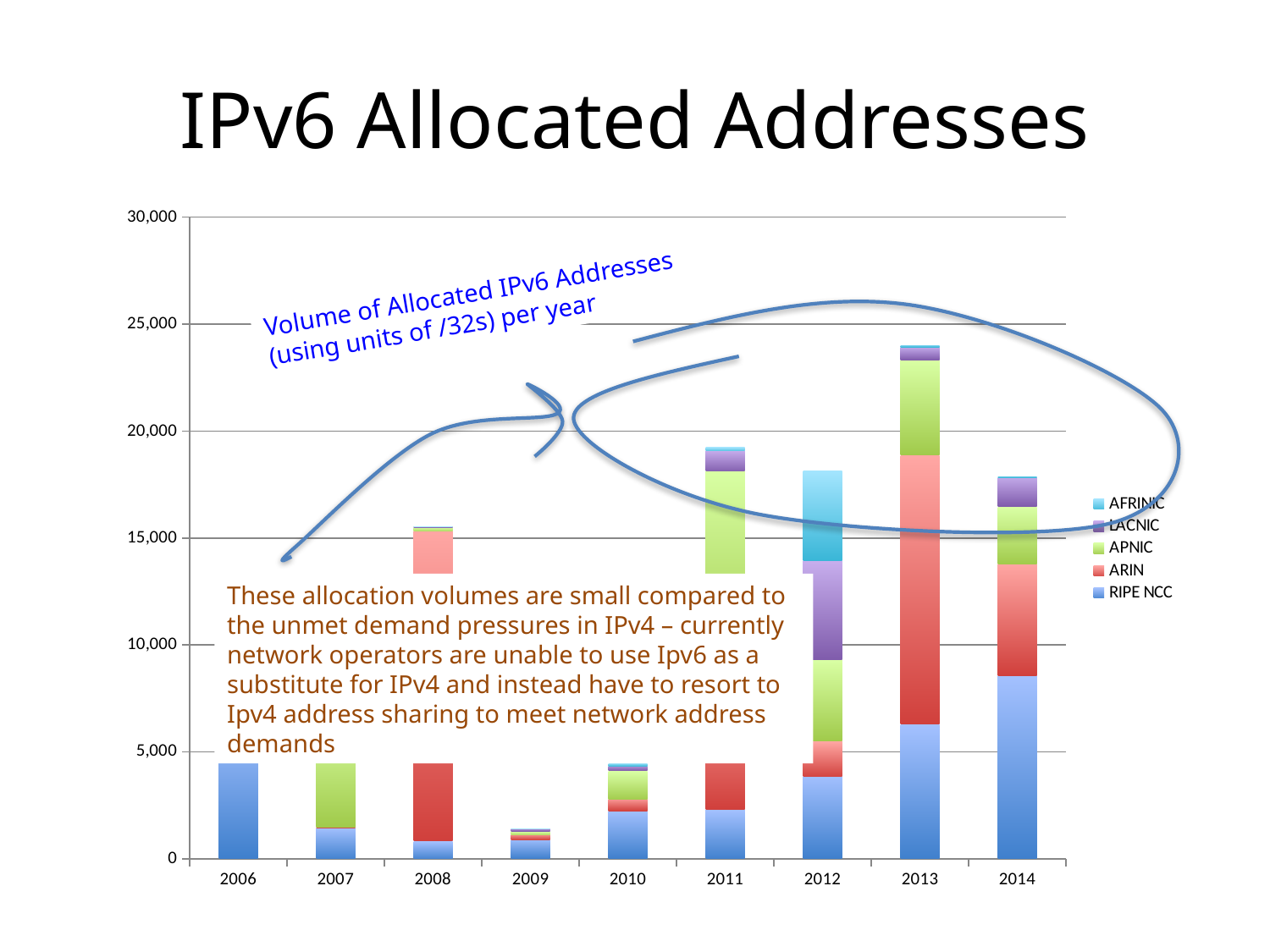
Which year has the taller stacked bar, 2013 or 2014? 2013 How many years are shown along the x axis of the chart? 9 Which year has the taller stacked bar, 2006 or 2009? 2006 Which year has the tallest stacked bar in the chart? 2013 Which year has the shortest stacked bar in the chart? 2009 Is the total stacked value for 2009 greater or less than 5,000? less What kind of chart is shown on the slide? Stacked bar chart Is the total stacked value for 2014 greater or less than 20,000? less Is the total stacked value for 2011 greater or less than 15,000? greater How many series does the chart's legend list? 5 Which series is listed first in the chart's legend? AFRINIC